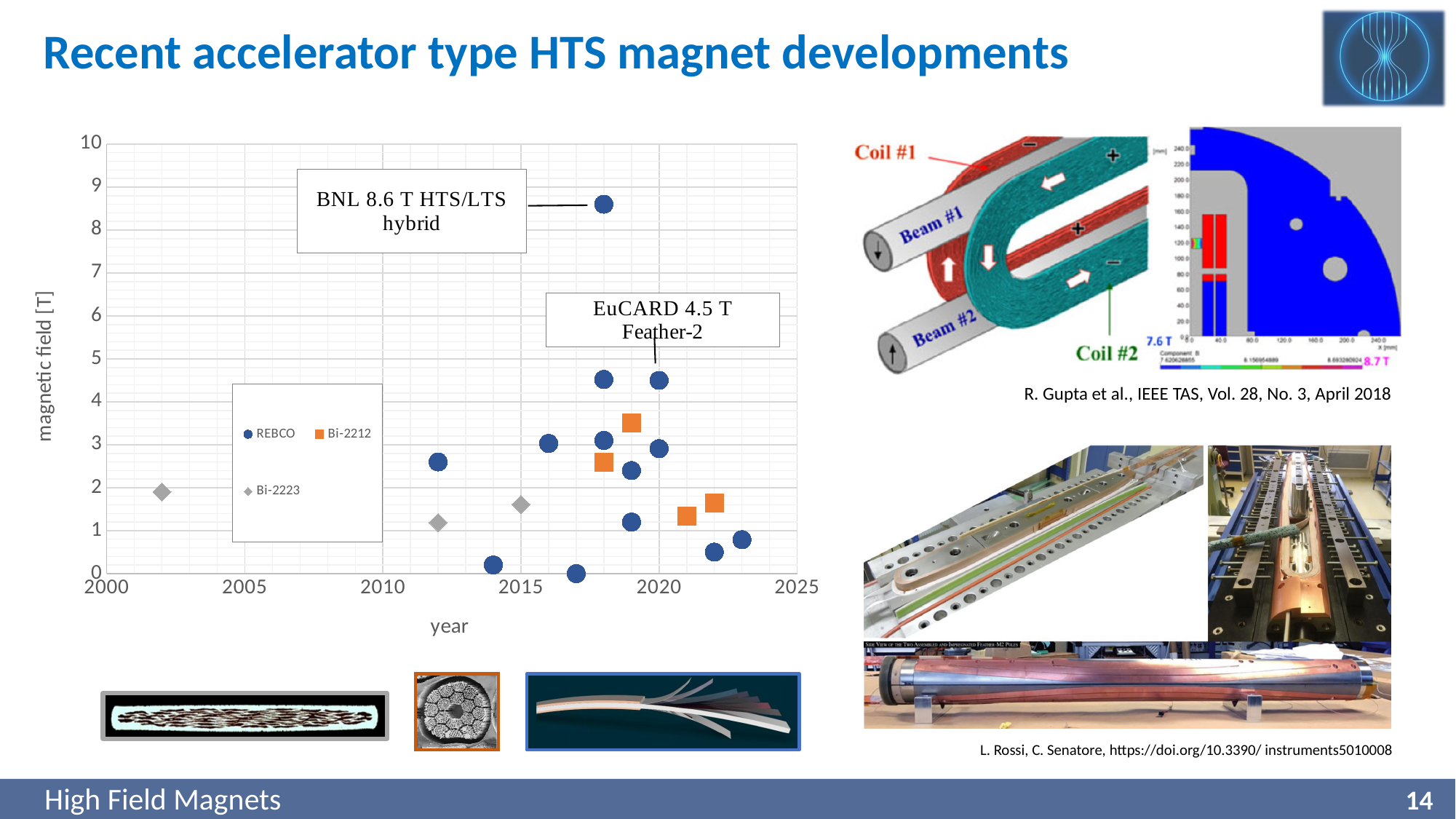
Is the Bi-2223 value plotted at year 2012 greater or less than 2 T? less What magnetic field value is given in the annotation for the EuCARD Feather-2 magnet? 4.5 T What kind of chart is shown on the slide? scatter chart Which series contains the highest magnetic field point on the chart? REBCO Is the Bi-2212 value plotted at year 2019 greater or less than 3 T? greater What magnetic field value is given in the annotation for the BNL HTS/LTS hybrid magnet? 8.6 T How many series does the chart legend list? 3 What is the label of the vertical axis of the chart? magnetic field [T] What is the difference between the annotated BNL HTS/LTS hybrid field and the EuCARD Feather-2 field? 4.1 T Which annotated magnet has the larger magnetic field, the BNL HTS/LTS hybrid or the EuCARD Feather-2? BNL HTS/LTS hybrid How many Bi-2223 data points are plotted on the chart? 3 What are the three series named in the chart legend? REBCO, Bi-2212, Bi-2223